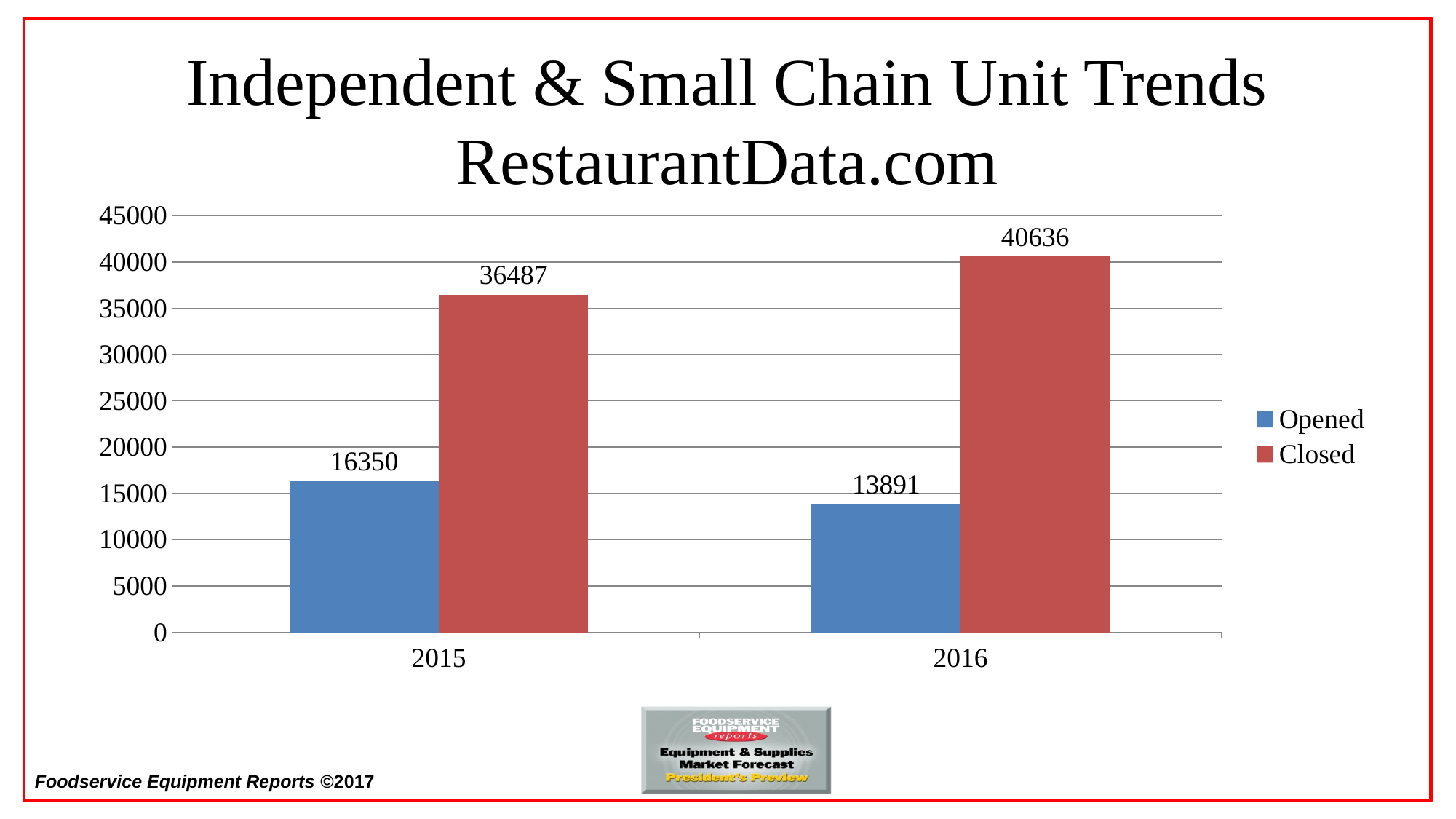
Which year has the lowest Opened value? 2016 What is the difference between Closed and Opened in 2016? 26745 What is the value for Closed in 2015? 36487 What is the difference between the Closed values for 2016 and 2015? 4149 How many series does the legend list? 2 Which is larger in 2015, Opened or Closed? Closed Does the Opened value rise or fall from 2015 to 2016? Fall What is the value for Closed in 2016? 40636 Which year has the highest Closed value? 2016 What is the value for Opened in 2015? 16350 What kind of chart is shown on the slide? Bar chart What is the value for Opened in 2016? 13891